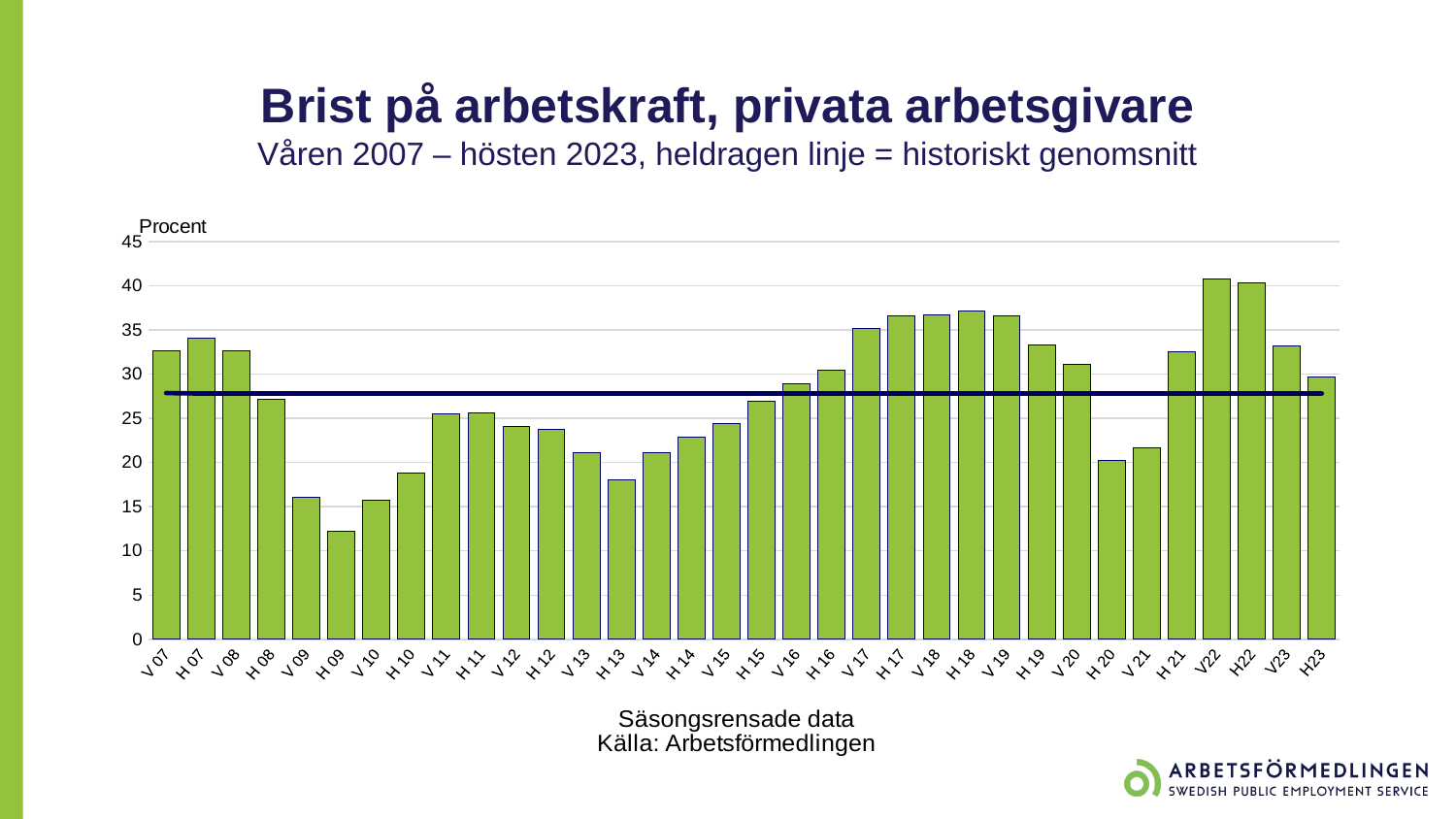
Is the value for H 09 greater or less than 15? less What kind of chart is shown on the slide? bar chart How many bars (survey periods) are plotted in the chart? 34 Is the value for H 10 greater or less than 20? less Which is larger, the value for V 07 or the value for H 07? H 07 Do the values rise or fall from V 07 to H 09? fall Is the value for V 07 greater or less than 30? greater Which is larger, the value for V 19 or the value for H 19? V 19 Which period has the lowest value in the chart? H 09 What is the label on the vertical axis of the chart? Procent